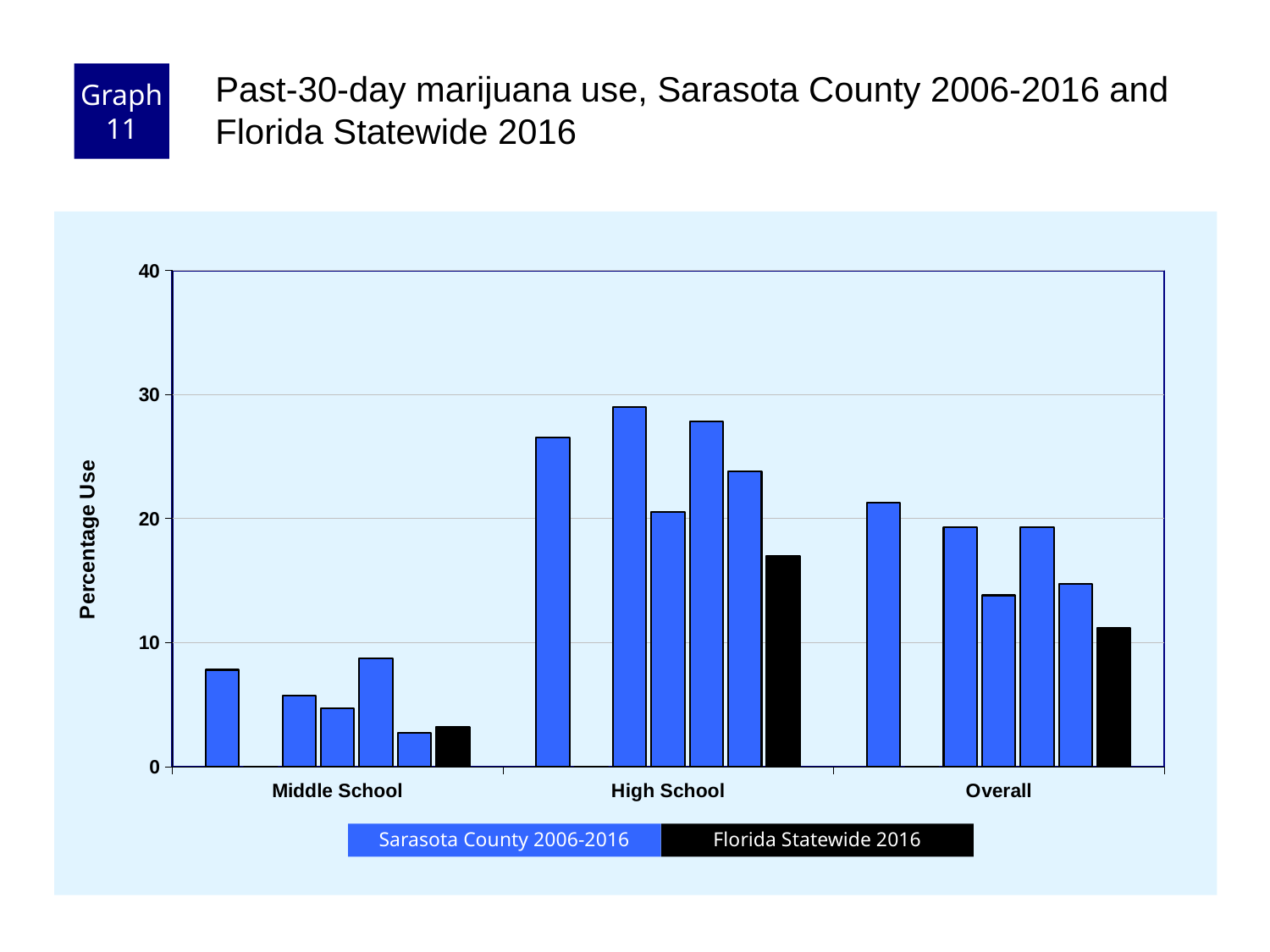
Which category has the lowest Florida Statewide 2016 value? Middle School Which is larger, the Florida Statewide 2016 value for High School or for Middle School? High School What kind of chart is shown on the slide? bar chart Is the Florida Statewide 2016 value for Middle School greater or less than 10? less Is the tallest bar in the chart greater or less than 30? less Is the Florida Statewide 2016 value for Overall greater or less than 20? less How many categories are shown on the x axis? 3 What is the title of the y axis? Percentage Use How many series does the legend list? 2 Which category has the highest Florida Statewide 2016 value? High School